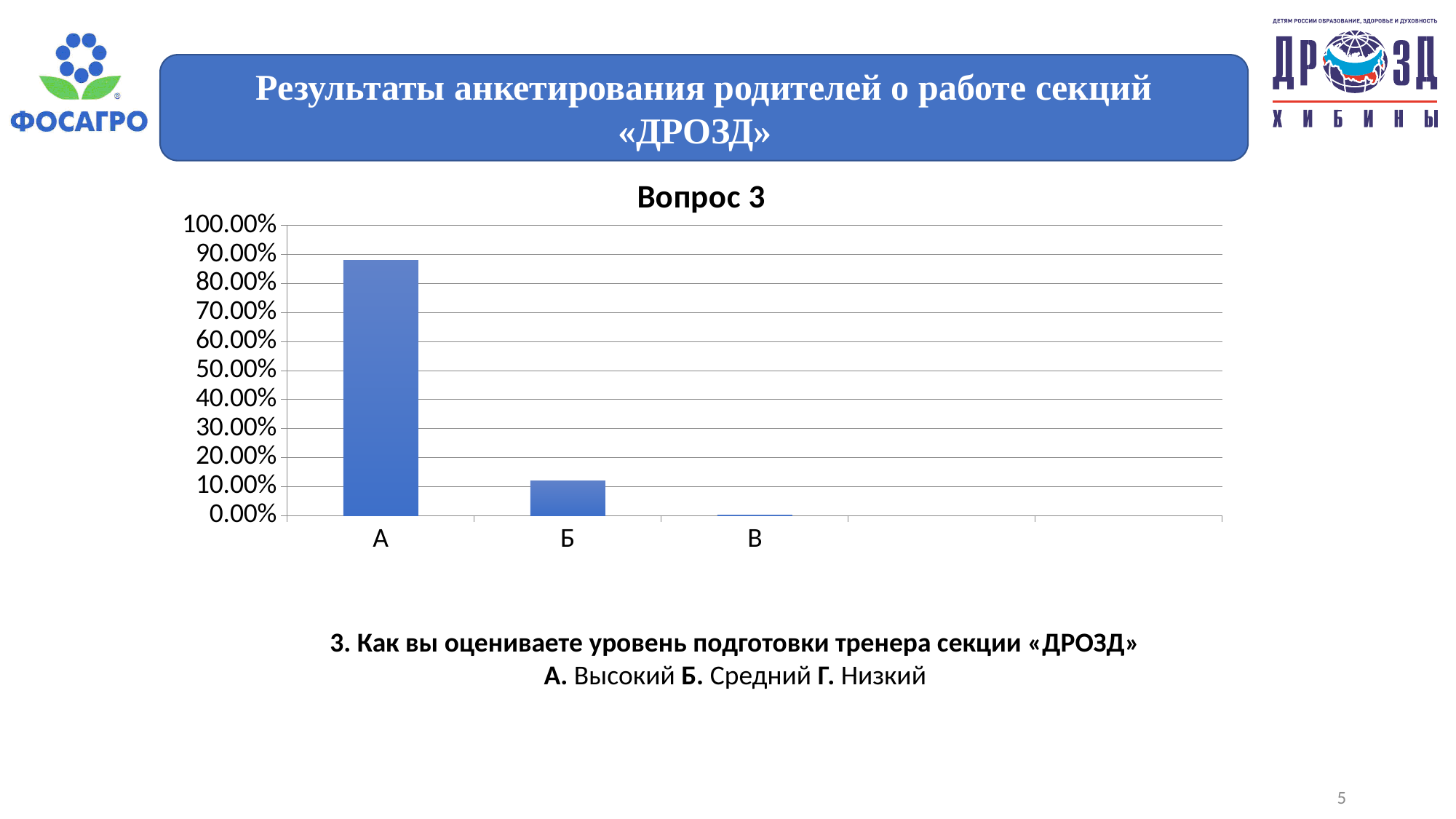
Do the values rise or fall from А to В along the x axis? fall Which category has the lowest value in the chart? В Is the value for А greater or less than 90.00%? less Which is larger, the value for А or the value for Б? А Is the value for В greater or less than 10.00%? less Is the value for Б greater or less than 20.00%? less Which category has the highest value in the chart? А How many labeled categories are shown on the x axis of the chart? 3 What is the title of the chart? Вопрос 3 What kind of chart is shown on the slide? bar chart